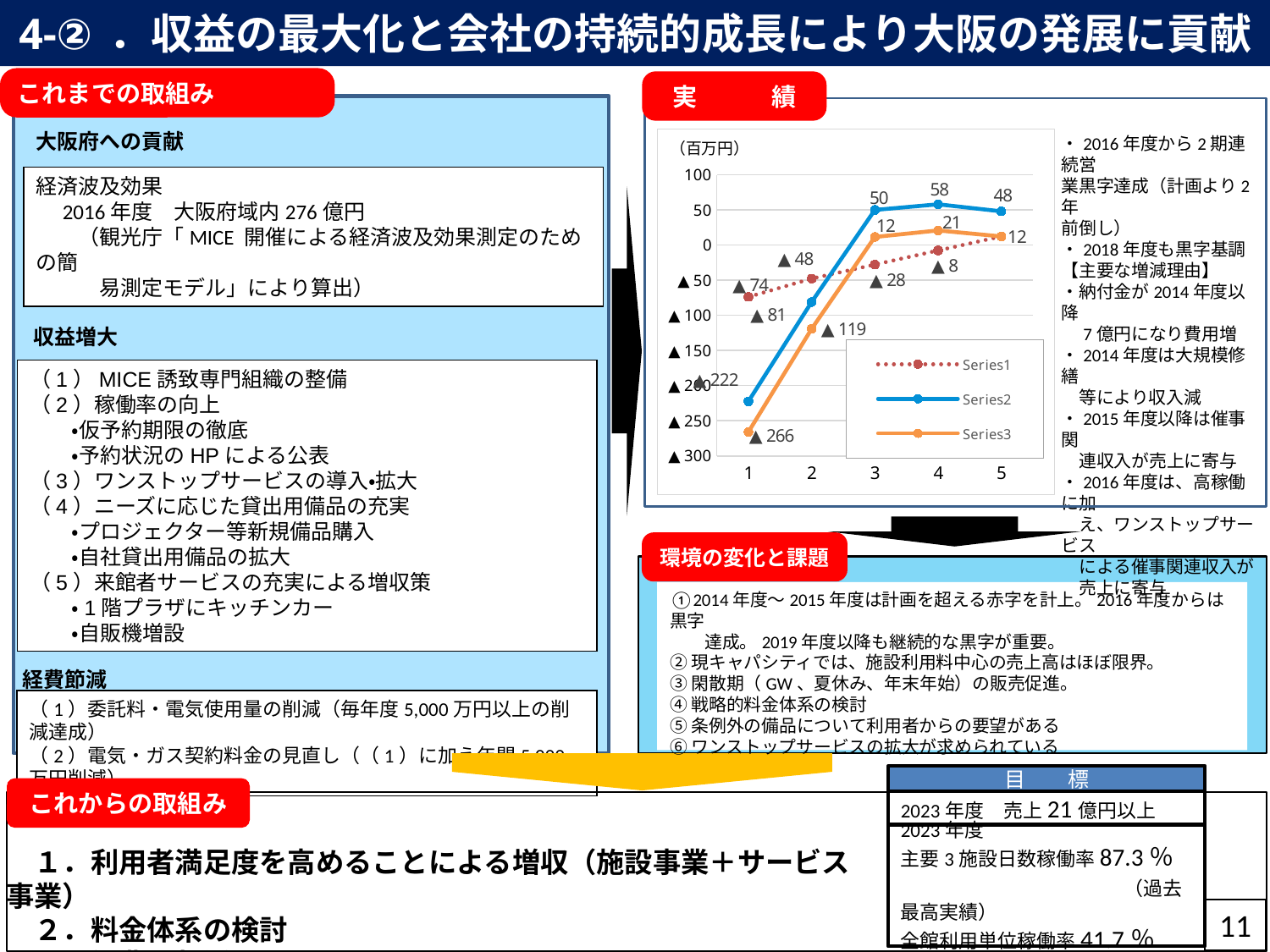
What is the value of Series2 at x = 4? 58 At which x value does Series2 reach its highest value? 4 Does Series1 rise or fall from x = 1 to x = 5? rise At x = 3, which is larger, Series2 or Series3? Series2 What is the value of Series3 at x = 4? 21 What is the value of Series2 at x = 3? 50 What kind of chart is shown on the slide? line chart What unit is shown at the top of the chart's y axis? 百万円 How many points are plotted along the x axis for each series? 5 What is the value of Series2 at x = 5? 48 What is the difference between Series2 and Series3 at x = 4? 37 How many series does the chart legend list? 3